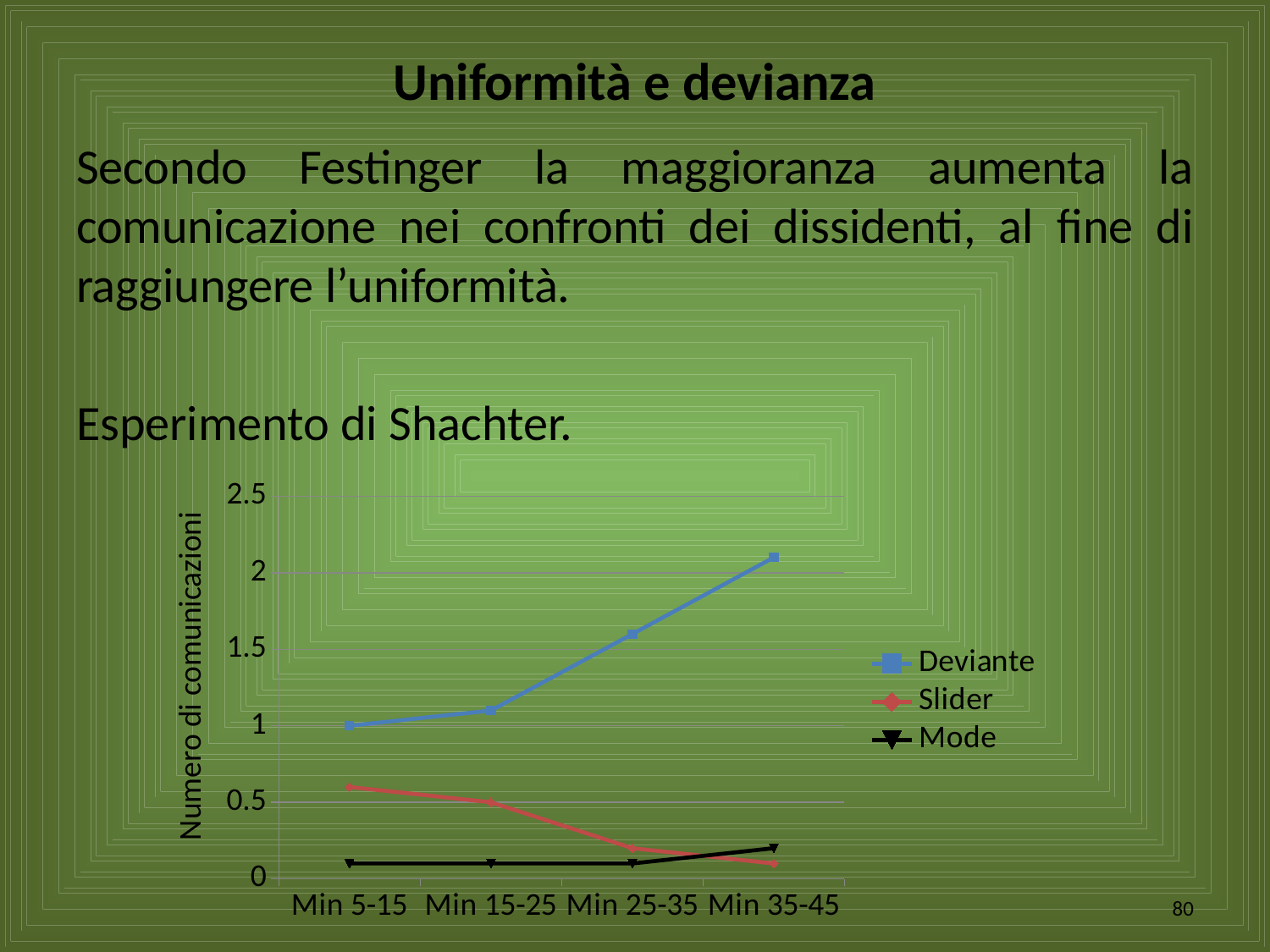
Does the Deviante series rise or fall from Min 5-15 to Min 35-45? rise Which series has the lowest value at Min 5-15? Mode What kind of chart is shown on the slide? line chart What is the title of the chart's vertical axis? Numero di comunicazioni How many series does the chart legend list? 3 Does the Slider series rise or fall from Min 5-15 to Min 35-45? fall How many time intervals are shown on the x axis of the chart? 4 Is the value for Slider at Min 25-35 greater or less than 0.5? less At Min 35-45, which is larger: the value for Deviante or the value for Slider? Deviante Is the value for Deviante at Min 35-45 greater or less than 1.5? greater Which series has the highest value at Min 25-35? Deviante Is the value for Mode at Min 15-25 greater or less than 0.5? less